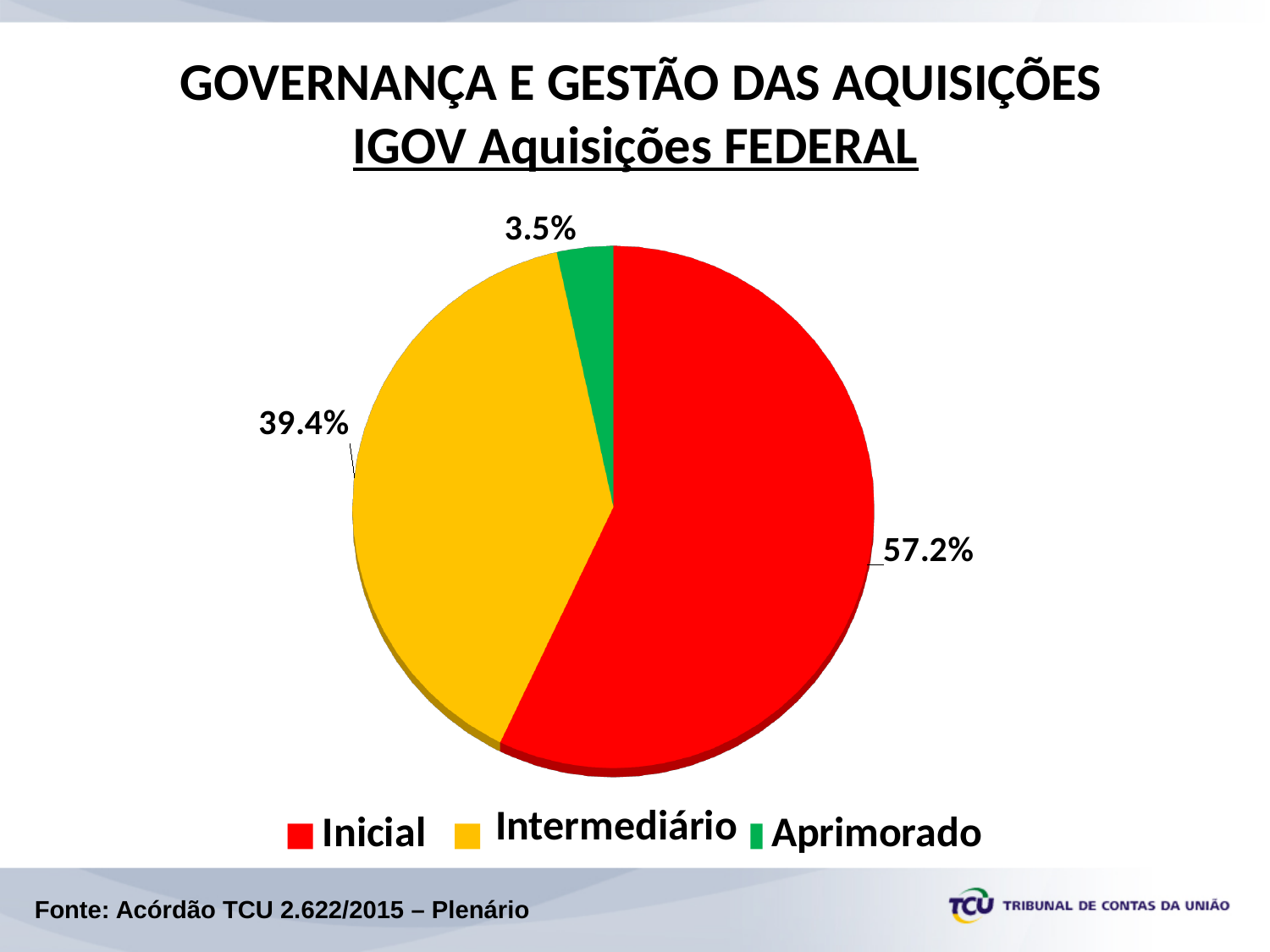
How many categories does the pie chart have? 3 Which category has the largest slice of the pie? Inicial What share of the pie does the Aprimorado slice represent? 3.5% What is the underlined subtitle of the chart? IGOV Aquisições FEDERAL Which category has the smallest slice of the pie? Aprimorado What share of the pie does the Inicial slice represent? 57.2% What type of chart is shown on the slide? pie chart What is the difference in percentage points between the Intermediário and Aprimorado slices? 35.9 What colour is the Aprimorado slice? green What share of the pie does the Intermediário slice represent? 39.4% Which slice is larger, Intermediário or Aprimorado? Intermediário What is the difference in percentage points between the Inicial and Intermediário slices? 17.8